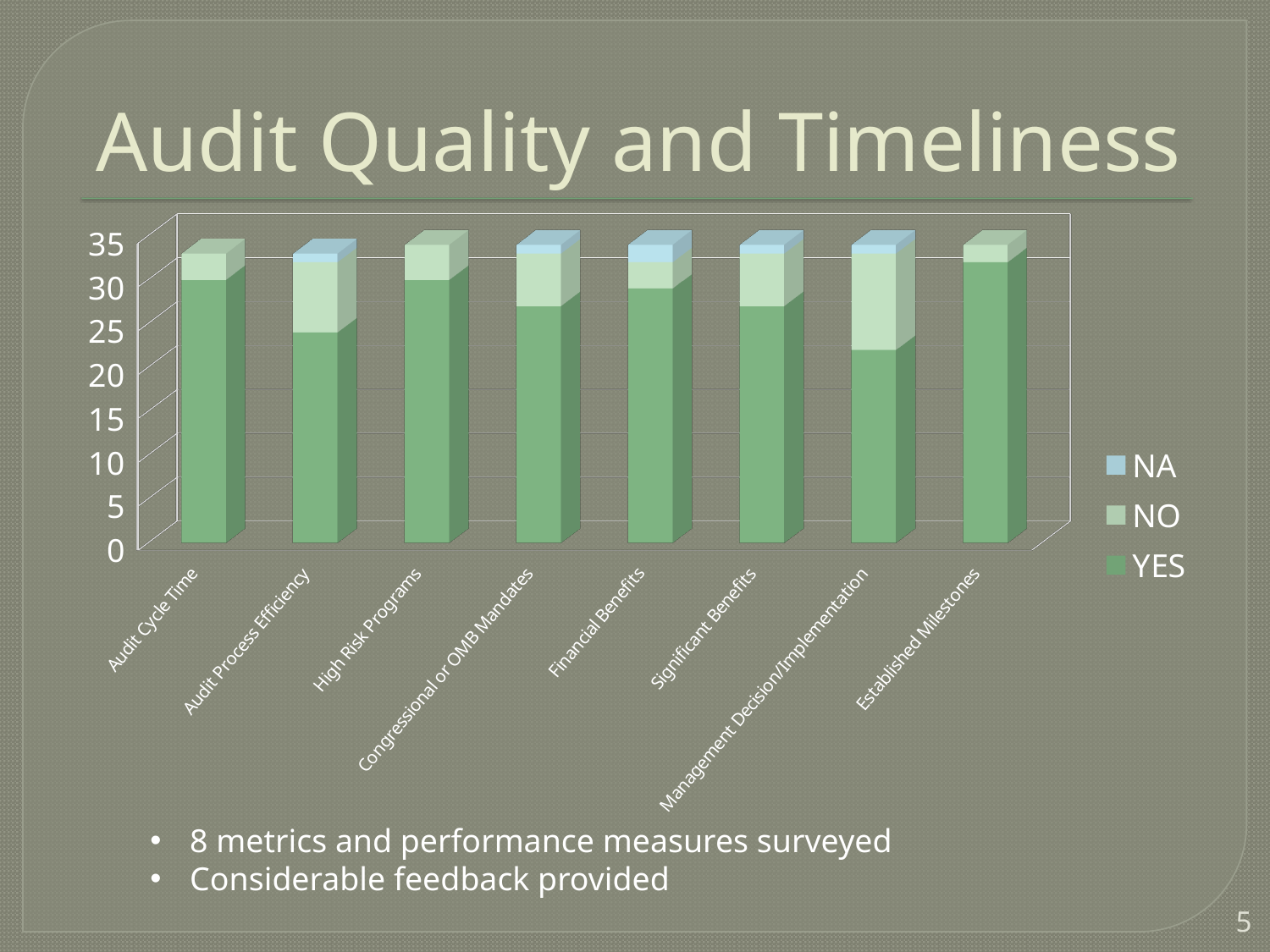
Is the YES value for Management Decision/Implementation greater or less than 25? less What kind of chart is shown on the slide? bar chart How many series does the chart's legend list? 3 Which category has the lowest YES value? Management Decision/Implementation Which has the larger YES value, Audit Cycle Time or Management Decision/Implementation? Audit Cycle Time What is the title of the slide containing the chart? Audit Quality and Timeliness How many categories are shown along the x axis of the chart? 8 Which has the larger YES value, Audit Process Efficiency or High Risk Programs? High Risk Programs Which series are listed in the chart's legend? NA, NO, YES Is the YES value for Audit Cycle Time greater or less than 25? greater Which category has the largest NO segment? Management Decision/Implementation Is the YES value for Established Milestones greater or less than 25? greater